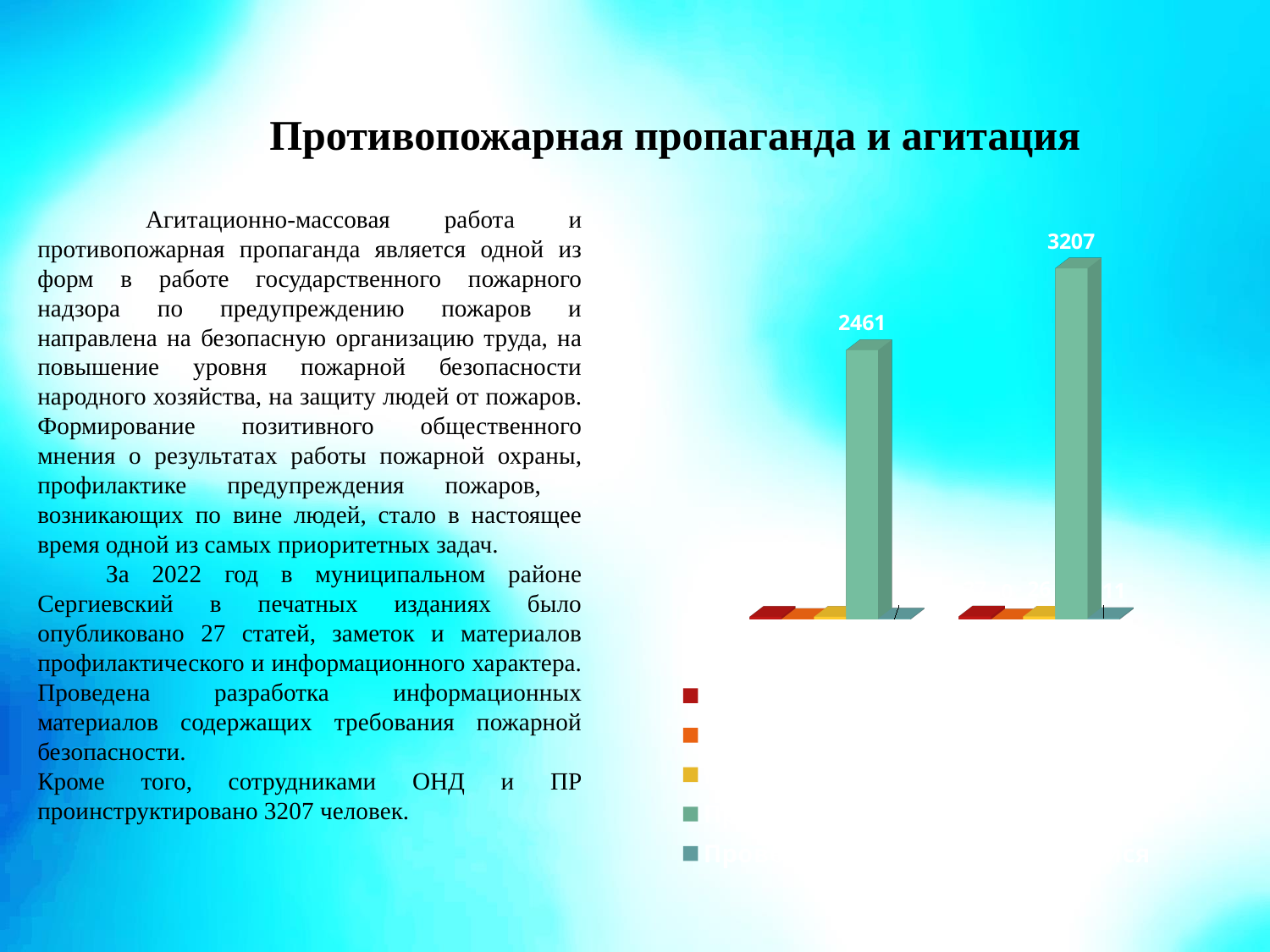
How many groups of bars are plotted on the chart? 2 What is the value printed above the tall green bar in the right group of the chart? 3207 Do the labelled values rise or fall from the left group to the right group? rise How many colour entries does the chart legend show? 5 What colour is the tallest bar in each group of the chart? green Which group, left or right, has the taller green bar? right What is the title of the slide containing the chart? Противопожарная пропаганда и агитация What kind of chart is shown on the slide? bar chart What is the difference between the two labelled values on the chart, 3207 and 2461? 746 Which group, left or right, has the shorter green bar? left What is the value printed above the tall green bar in the left group of the chart? 2461 Is the labelled value in the right group larger or smaller than the labelled value in the left group? larger